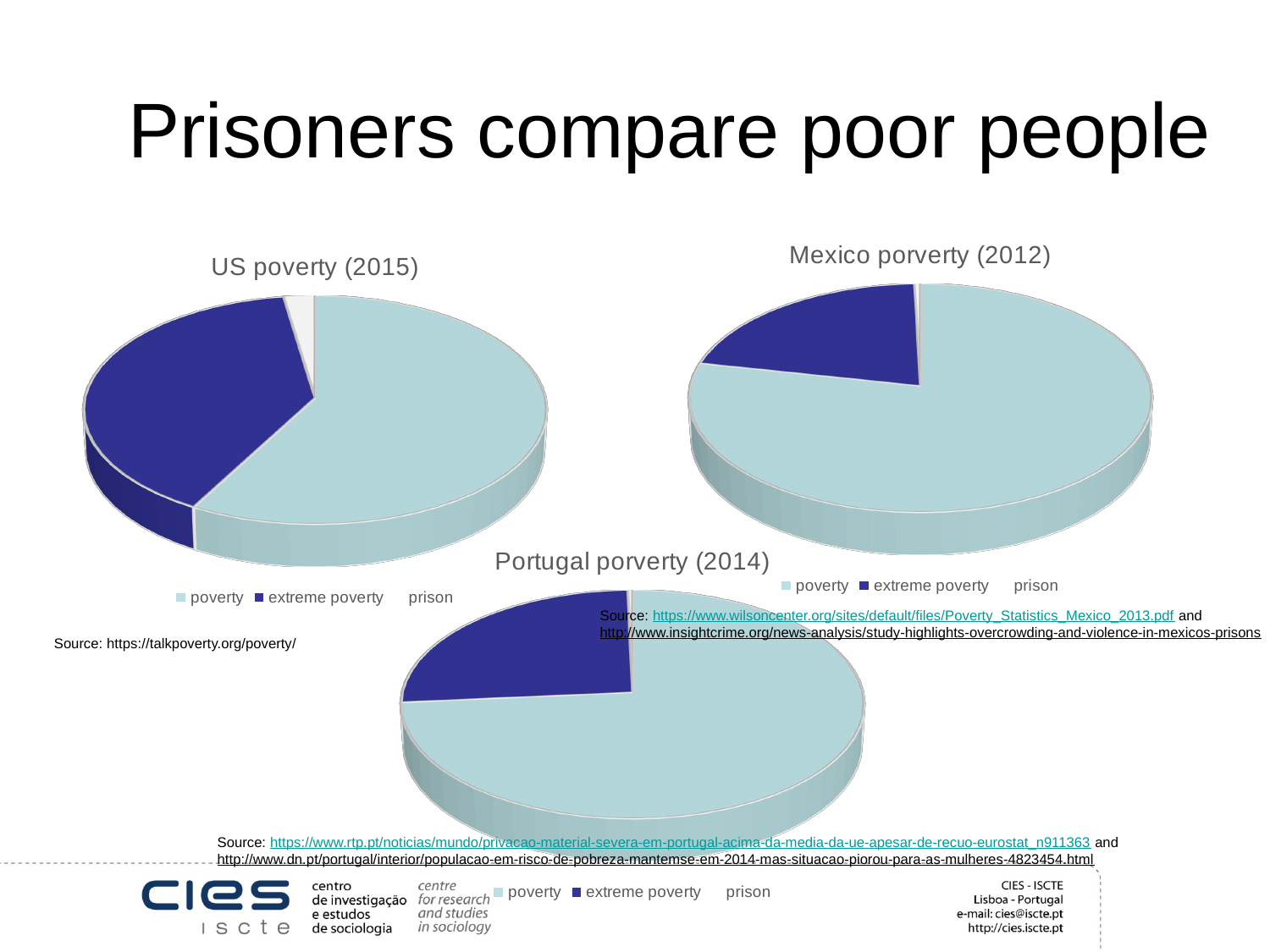
How many entries does the legend of the "Mexico porverty (2012)" chart list? 3 How many pie charts are shown on the slide? 3 In the "Mexico porverty (2012)" chart, which category has the smallest slice? prison In the "US poverty (2015)" chart, which category has the smallest slice? prison In the "Mexico porverty (2012)" chart, which category has the largest slice? poverty In the "US poverty (2015)" chart, which is larger, the extreme poverty slice or the prison slice? extreme poverty In the "Portugal porverty (2014)" chart, which category has the largest slice? poverty In the "Portugal porverty (2014)" chart, which is larger, the poverty slice or the extreme poverty slice? poverty What kind of chart is the "US poverty (2015)" chart? pie chart In the "Mexico porverty (2012)" chart, what colour represents extreme poverty? dark blue What is the title of the pie chart at the bottom of the slide? Portugal porverty (2014) In the "US poverty (2015)" chart, which category has the largest slice? poverty